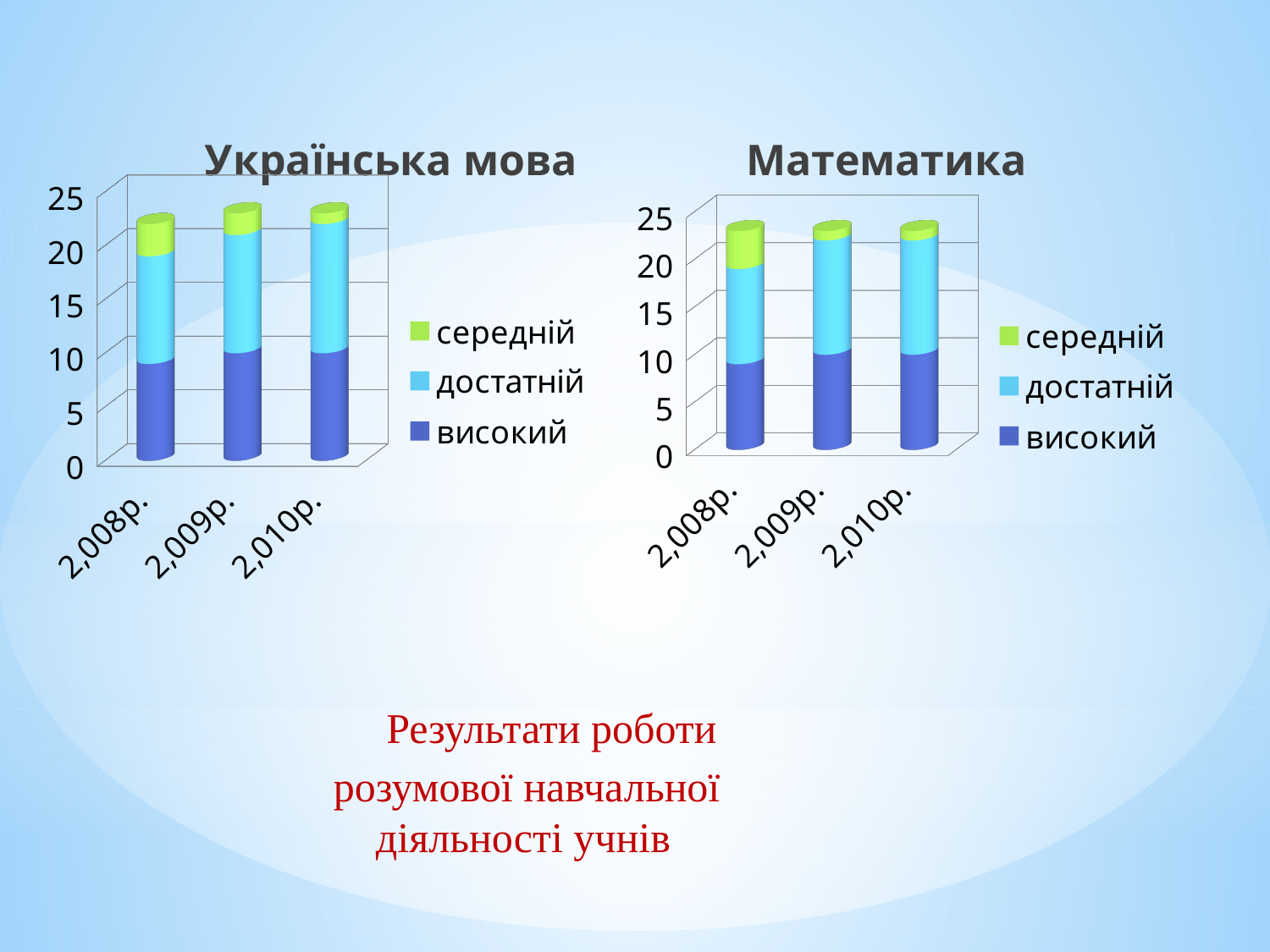
In the "Українська мова" chart, is the "високий" segment for 2,009р. greater or less than 15? less How many series does the legend of the "Математика" chart list? 3 In the "Математика" chart, is the "високий" segment for 2,010р. greater or less than 5? greater In the "Математика" chart, is the total height of the stacked bar for 2,010р. greater or less than 25? less In the "Математика" chart, which year has the larger "середній" segment, 2,008р. or 2,010р.? 2,008р. How many categories are shown on the x axis of the "Українська мова" chart? 3 What is the title of the chart on the right side of the slide? Математика In the "Українська мова" chart, which year has the larger "середній" segment, 2,008р. or 2,010р.? 2,008р. What type of chart is the "Українська мова" chart? bar chart Which legend entry is shown in green in the "Українська мова" chart? середній